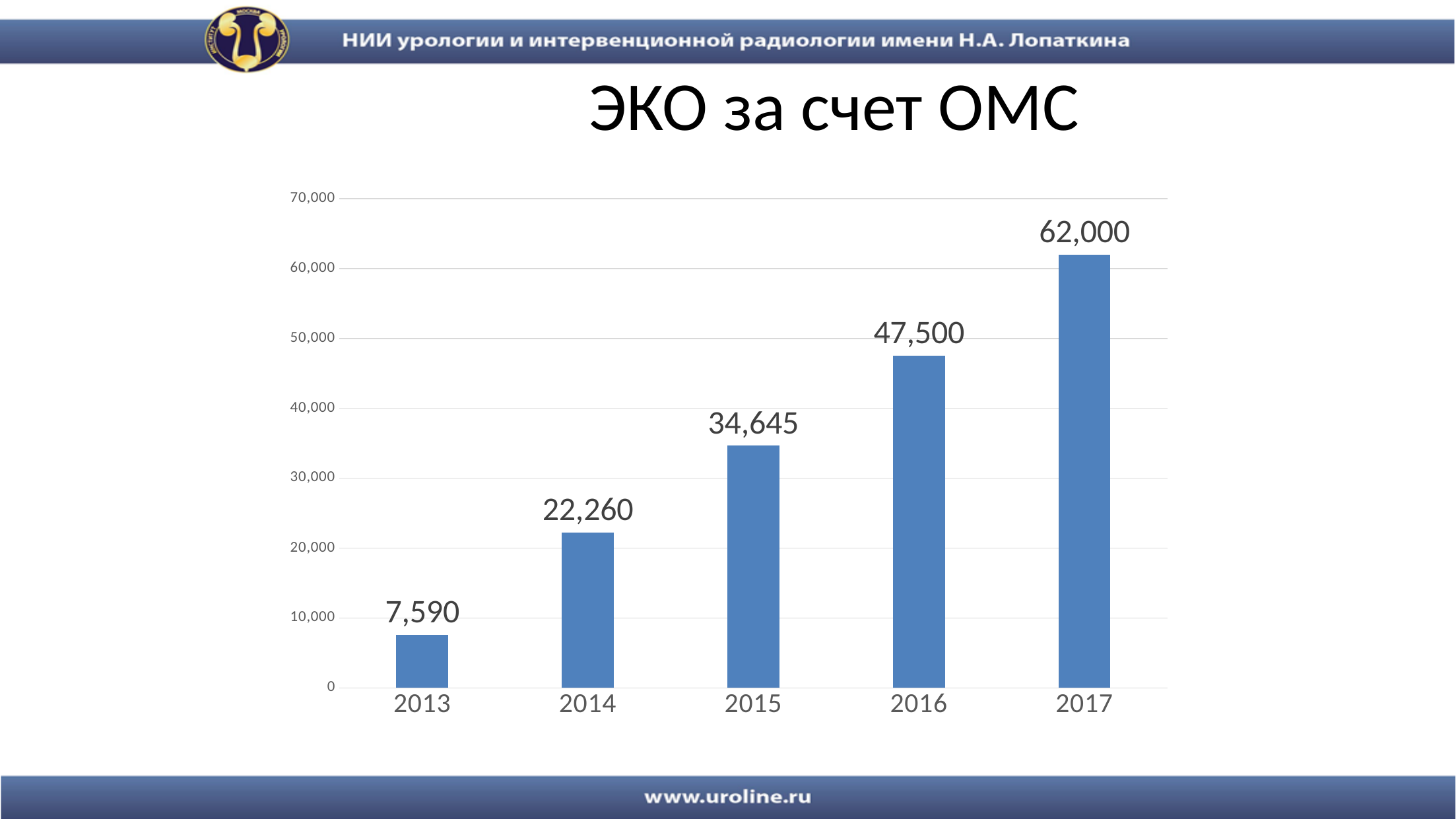
Which year has the lowest value? 2013 What is the difference between the values for 2017 and 2016? 14,500 What is the value for 2013? 7,590 Which is larger, the value for 2015 or the value for 2014? 2015 What is the value for 2015? 34,645 What is the value for 2017? 62,000 What kind of chart is shown on the slide? bar chart What is the difference between the values for 2014 and 2013? 14,670 How many years are shown on the x axis? 5 Is the value for 2016 greater or less than 40,000? greater Which year has the highest value? 2017 Do the values rise or fall from 2013 to 2017? rise